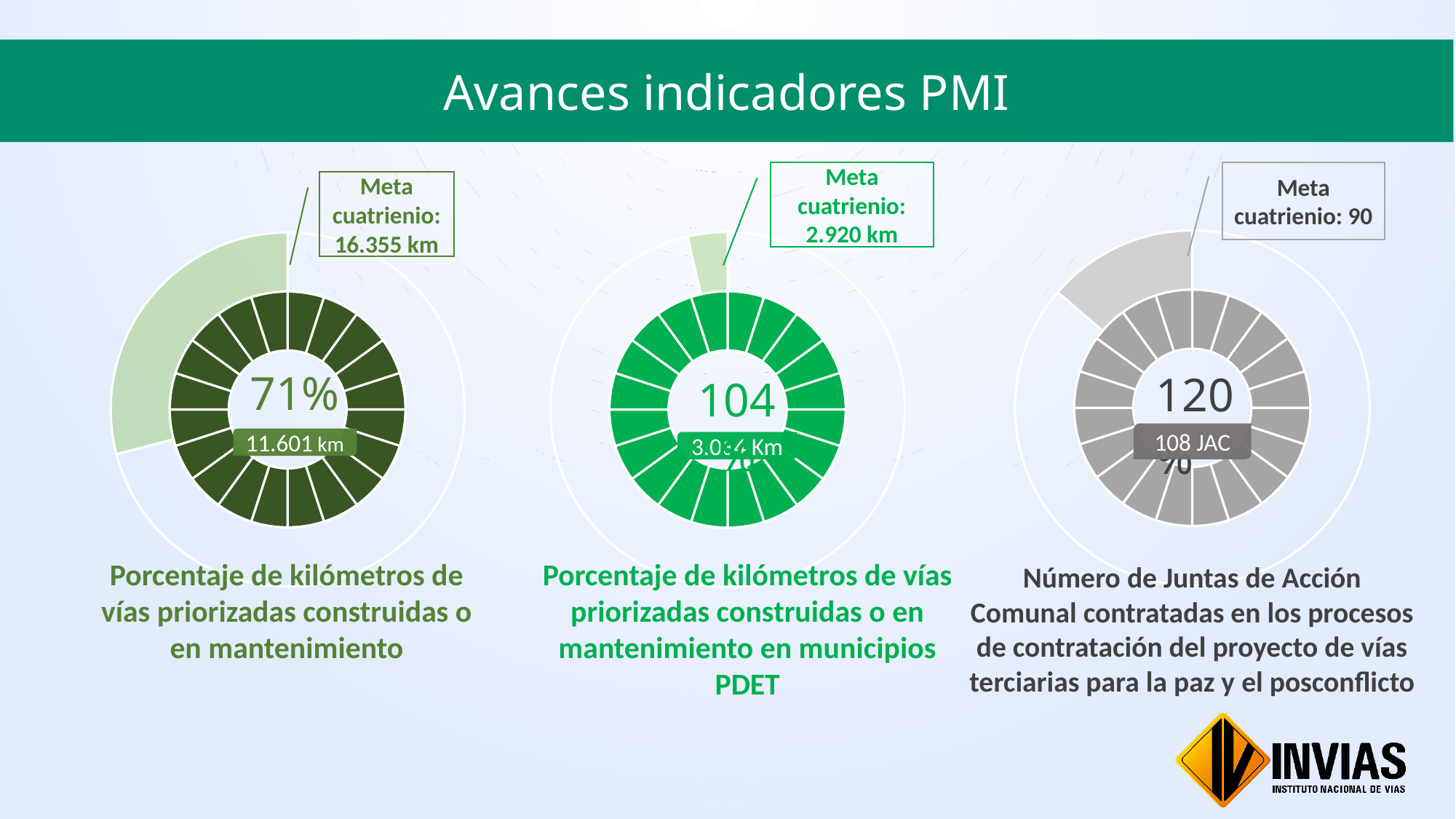
What is the 'Meta cuatrienio' for the middle chart about PDET municipalities? 2.920 km What number is shown in the centre of the middle chart about PDET municipalities? 104 What is the 'Meta cuatrienio' for the right chart about Juntas de Acción Comunal? 90 On the right chart, how many JAC are shown in the label below the central number? 108 JAC On the right chart, is the number of JAC contracted (108) greater or less than the meta cuatrienio of 90? greater How many gauge charts are shown on the slide? 3 On the left chart, how many kilometres are shown in the label below the percentage? 11.601 km What is the title of the slide? Avances indicadores PMI What percentage is shown in the centre of the left chart, 'Porcentaje de kilómetros de vías priorizadas construidas o en mantenimiento'? 71% Which chart shows the lowest central value: the left, middle or right chart? Left chart (71%) What number is shown in the centre of the right chart about Juntas de Acción Comunal? 120 What is the 'Meta cuatrienio' for the left chart? 16.355 km